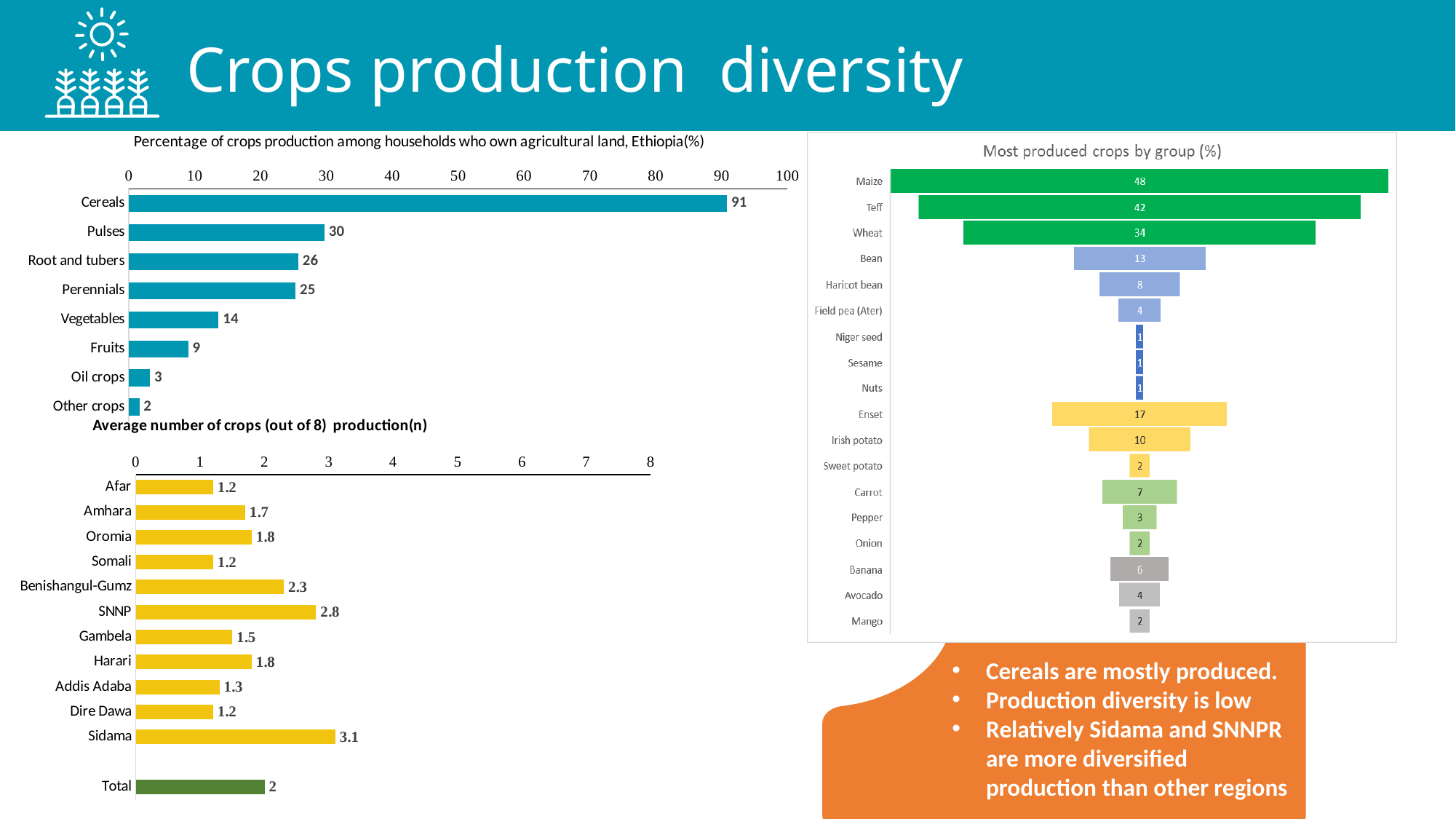
In the chart titled 'Average number of crops (out of 8) production(n)', which is larger, Amhara or Benishangul-Gumz? Benishangul-Gumz In the chart titled 'Average number of crops (out of 8) production(n)', what is the value for Total? 2 What kind of chart is the chart titled 'Most produced crops by group (%)'? Bar chart In the chart titled 'Percentage of crops production among households who own agricultural land, Ethiopia(%)', how many categories are shown? 8 In the chart titled 'Average number of crops (out of 8) production(n)', what is the value for SNNP? 2.8 In the chart titled 'Most produced crops by group (%)', what is the value for Teff? 42 In the chart titled 'Percentage of crops production among households who own agricultural land, Ethiopia(%)', which category has the lowest value? Other crops In the chart titled 'Percentage of crops production among households who own agricultural land, Ethiopia(%)', what is the difference between Pulses and Root and tubers? 4 In the chart titled 'Most produced crops by group (%)', which crop has the highest value? Maize In the chart titled 'Percentage of crops production among households who own agricultural land, Ethiopia(%)', what is the value for Cereals? 91 In the chart titled 'Most produced crops by group (%)', what is the difference between Enset and Irish potato? 7 In the chart titled 'Average number of crops (out of 8) production(n)', which region has the highest value? Sidama